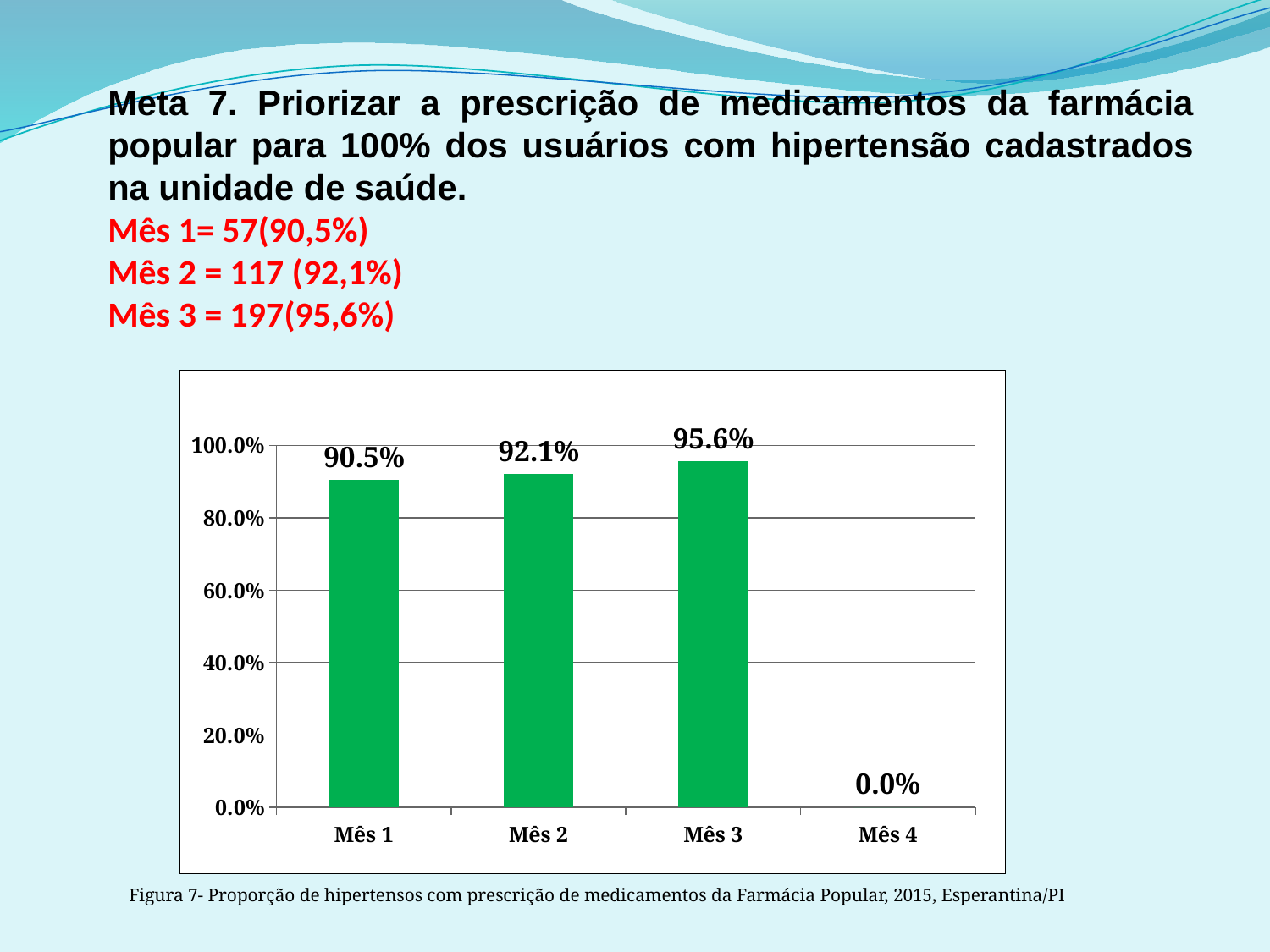
What is the value for Mês 3? 95.6% Which month has the lowest value? Mês 4 Is the value for Mês 1 greater or less than 80.0%? greater What kind of chart is shown on the slide? bar chart What is the value for Mês 2? 92.1% How many months are shown on the x axis? 4 Do the values rise or fall from Mês 1 to Mês 3? rise Which is larger, the value for Mês 2 or the value for Mês 3? Mês 3 What is the value for Mês 1? 90.5% What is the difference between the values for Mês 3 and Mês 1? 5.1% Which month has the highest value? Mês 3 What is the value for Mês 4? 0.0%